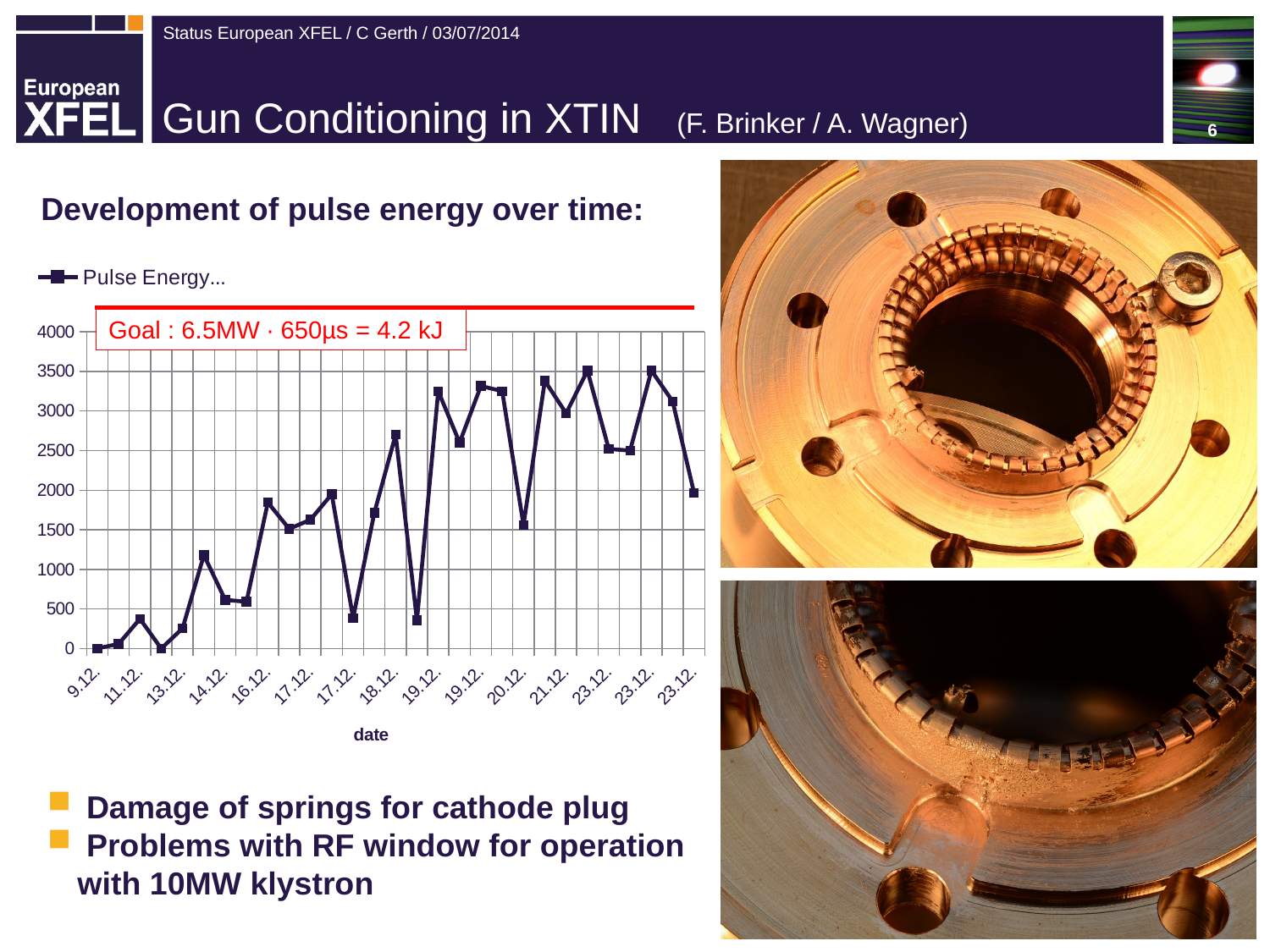
What goal value is stated in the annotation box on the chart? 6.5MW · 650µs = 4.2 kJ How many series does the chart legend list? 1 Is the highest pulse energy value on the chart greater or less than 3000? greater How many date labels are shown on the x axis of the chart? 15 What is the legend entry of the plotted series? Pulse Energy... Overall, does the pulse energy rise or fall from 9.12. to 23.12.? rise Is the last pulse energy value (at the final 23.12. label) greater or less than 1500? greater What kind of chart is shown on the slide? line chart Which is larger, the pulse energy at 9.12. or at the final 23.12. point? the final 23.12. point Is the pulse energy value at 14.12. greater or less than 2000? less